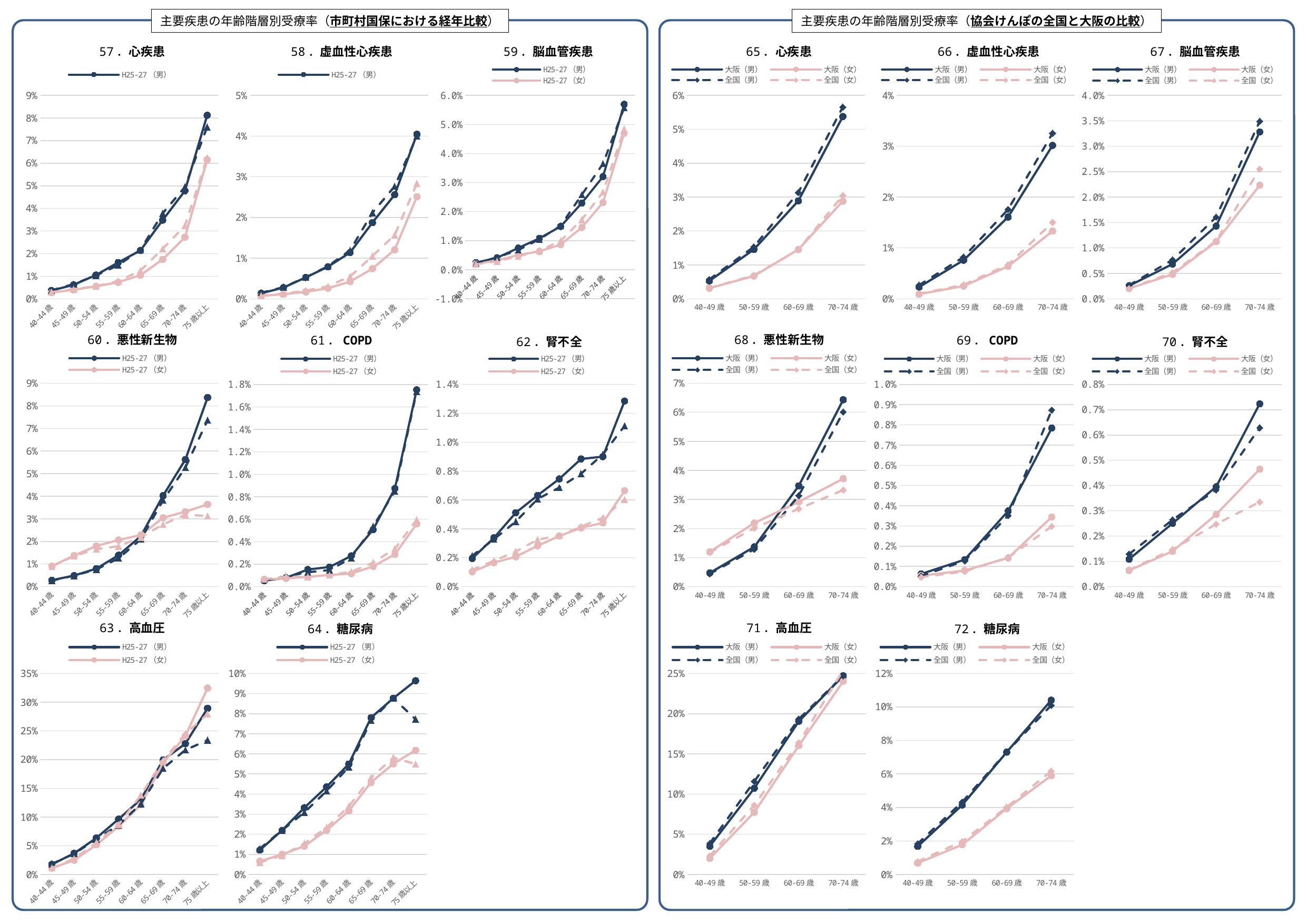
In chart "65．心疾患" on the right panel, is the value for 大阪（男） at 70-74歳 greater or less than 5%? greater How many age categories are shown on the x axis of chart "65．心疾患" on the right panel? 4 In chart "60．悪性新生物" on the left panel, which is larger at 40-44歳: H25-27（男） or H25-27（女）? H25-27（女） In chart "68．悪性新生物" on the right panel, which is larger at 70-74歳: 大阪（男） or 大阪（女）? 大阪（男） What is the title of the right-hand panel of charts? 主要疾患の年齢階層別受療率（協会けんぽの全国と大阪の比較） How many series does the legend of chart "63．高血圧" on the left panel list? 2 What kind of chart is "60．悪性新生物" on the left panel? line chart How many age categories are shown on the x axis of chart "57．心疾患" on the left panel? 8 How many series does the legend of chart "68．悪性新生物" on the right panel list? 4 In chart "72．糖尿病" on the right panel, do the values for 大阪（男） rise or fall from 40-49歳 to 70-74歳? rise In chart "71．高血圧" on the right panel, is the value for 大阪（男） at 60-69歳 greater or less than 20%? less In chart "64．糖尿病" on the left panel, is the value for H25-27（男） at 75歳以上 greater or less than 9%? greater